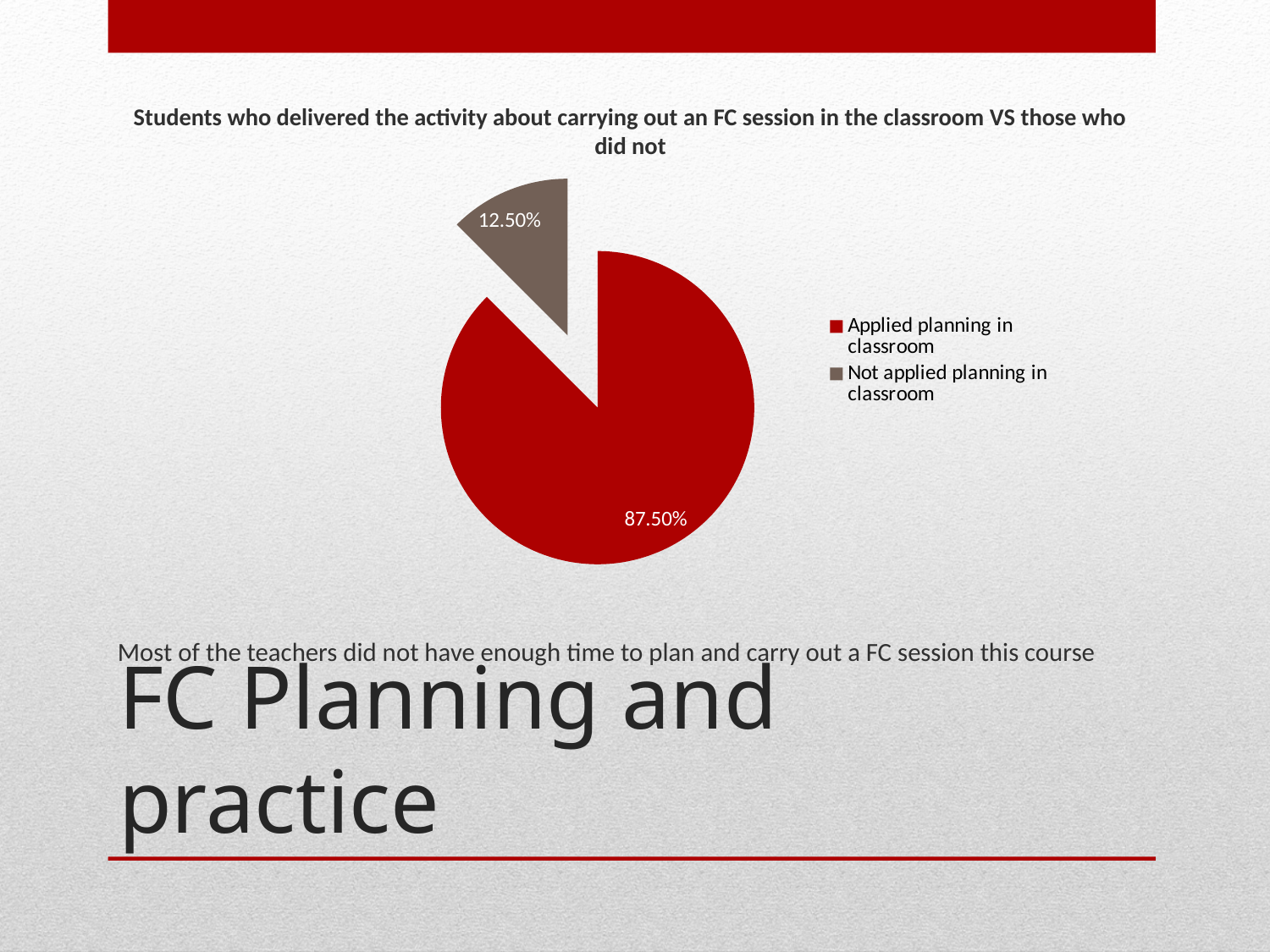
Which category has the largest share of the pie? Applied planning in classroom What is the total of the two slices shown in the pie chart? 100% How many slices does the pie chart have? 2 What colour is the 'Not applied planning in classroom' slice? Grey/brown How many entries does the legend list? 2 What percentage of students did not apply planning in the classroom? 12.50% What kind of chart is shown on the slide? Pie chart What is the difference in percentage points between the 'Applied planning in classroom' slice and the 'Not applied planning in classroom' slice? 75 percentage points What percentage of students applied planning in the classroom? 87.50% Which is larger: the share for 'Applied planning in classroom' or 'Not applied planning in classroom'? Applied planning in classroom What is the title of the chart? Students who delivered the activity about carrying out an FC session in the classroom VS those who did not Which category has the smallest share of the pie? Not applied planning in classroom